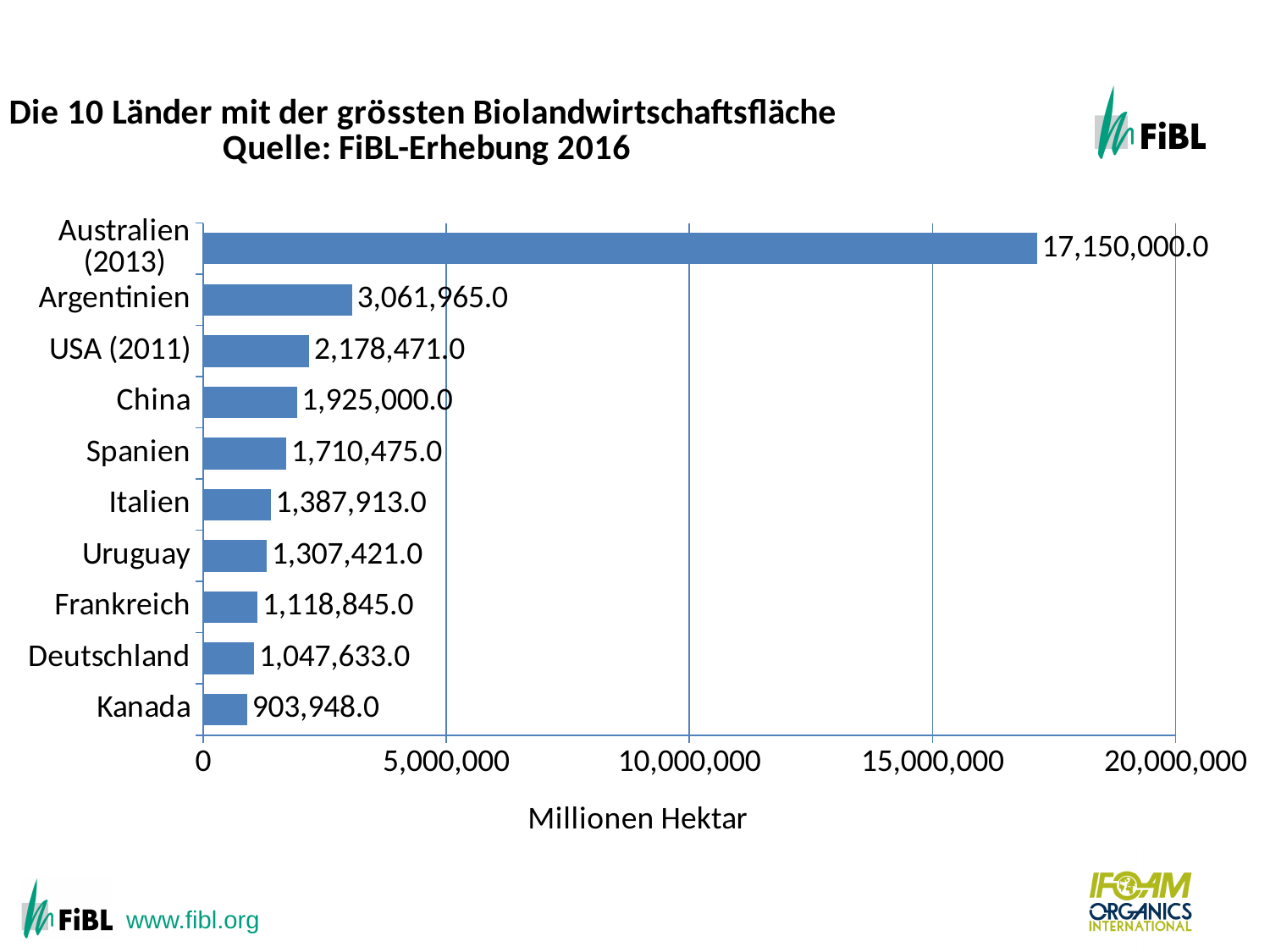
What is the difference between the values for Deutschland and Kanada? 143,685.0 Is the value for Australien (2013) greater or less than 15,000,000? greater Which is larger, the value for China or the value for Italien? China What is the value for Spanien? 1,710,475.0 What is the difference between the values for Argentinien and USA (2011)? 883,494.0 Which country has the lowest value? Kanada What is the label of the horizontal axis? Millionen Hektar What is the value for Argentinien? 3,061,965.0 How many countries are shown in the chart? 10 What is the value for Kanada? 903,948.0 Which country has the highest value? Australien (2013) What kind of chart is shown on the slide? bar chart